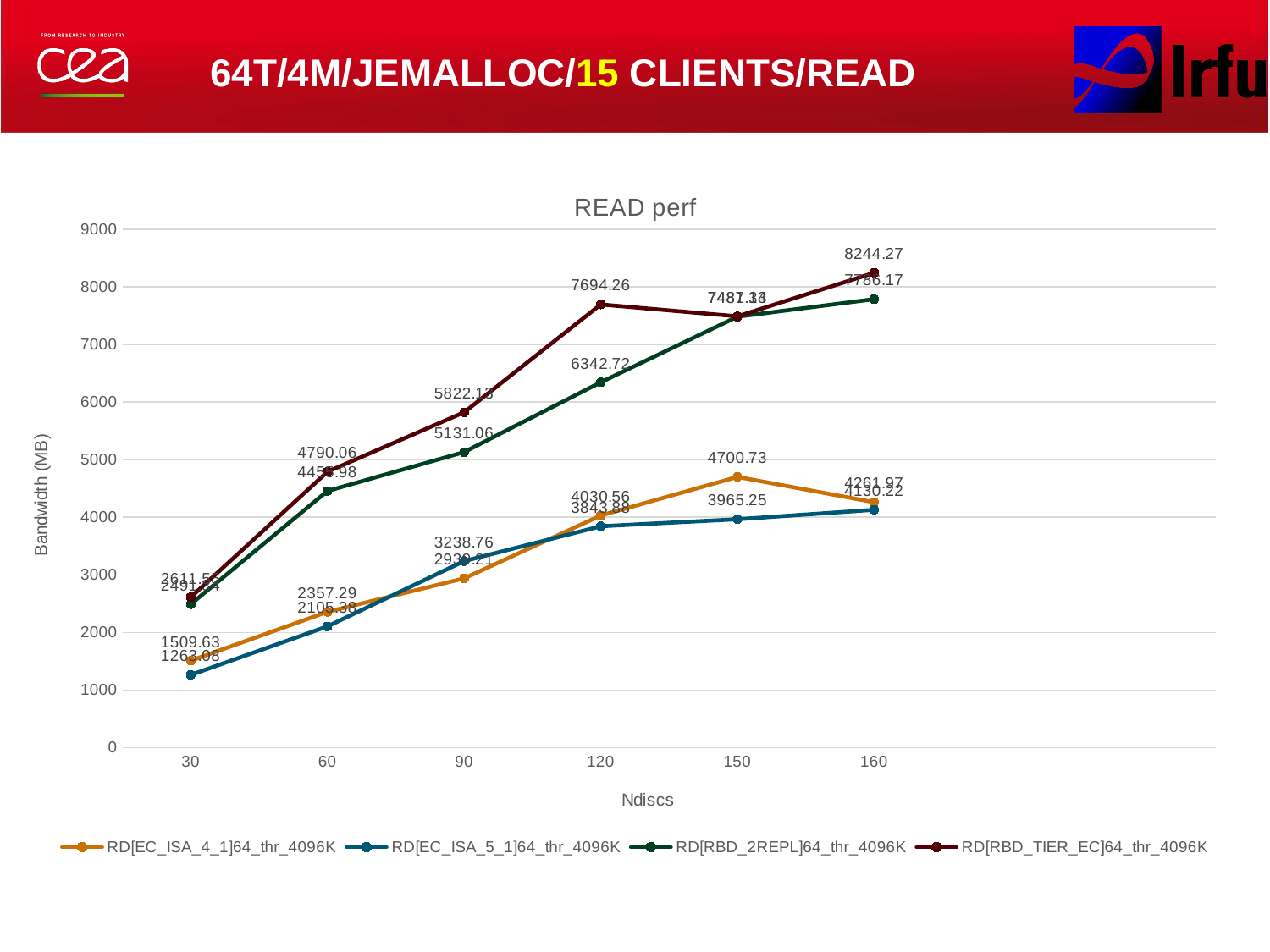
Which series has the lowest value at 30 Ndiscs? RD[EC_ISA_5_1]64_thr_4096K What kind of chart is shown on the slide? line chart What is the difference between RD[RBD_TIER_EC]64_thr_4096K and RD[RBD_2REPL]64_thr_4096K at 120 Ndiscs? 1351.54 Which series has the highest value at 160 Ndiscs? RD[RBD_TIER_EC]64_thr_4096K What is the value of RD[EC_ISA_5_1]64_thr_4096K at 150 Ndiscs? 3965.25 For RD[EC_ISA_4_1]64_thr_4096K, is the value higher at 150 or at 160 Ndiscs? 150 Is the value for RD[EC_ISA_5_1]64_thr_4096K at 30 Ndiscs greater or less than 2000? less What is the value of RD[EC_ISA_4_1]64_thr_4096K at 150 Ndiscs? 4700.73 What is the value of RD[RBD_2REPL]64_thr_4096K at 120 Ndiscs? 6342.72 How many series does the legend of the READ perf chart list? 4 What is the value of RD[RBD_TIER_EC]64_thr_4096K at 160 Ndiscs? 8244.27 How many Ndiscs values are plotted along the x axis of the READ perf chart? 6